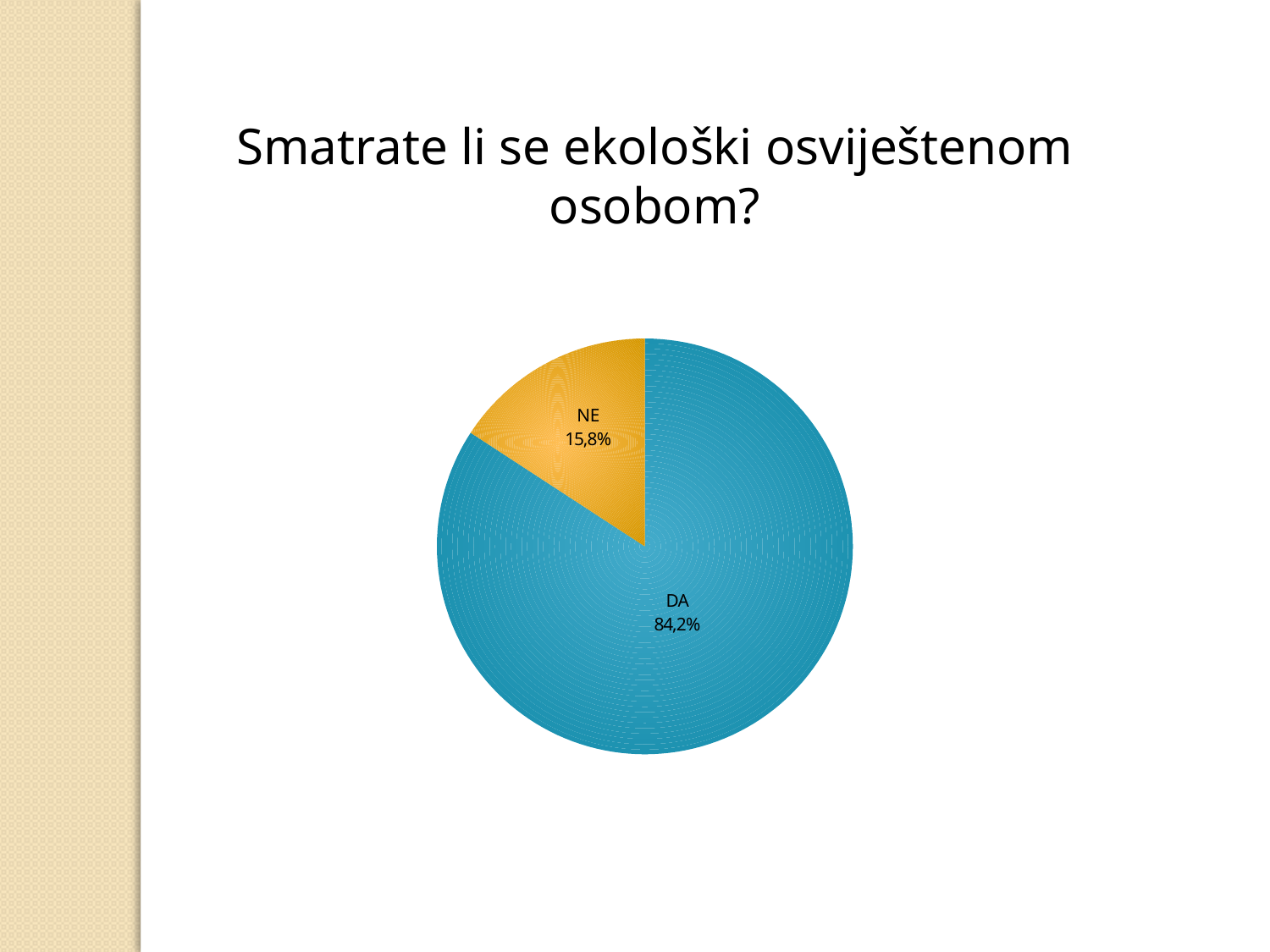
Which is larger, the DA slice or the NE slice? DA What colour is the NE slice of the pie chart? orange What kind of chart is shown on the slide? pie chart What share of the pie does the DA slice represent? 84,2% Which slice is the smallest in the pie chart? NE What is the difference in percentage points between the DA and NE slices? 68,4 What is the title of the slide above the pie chart? Smatrate li se ekološki osviještenom osobom? What share of the pie does the NE slice represent? 15,8% How many slices does the pie chart have? 2 Which slice is the largest in the pie chart? DA